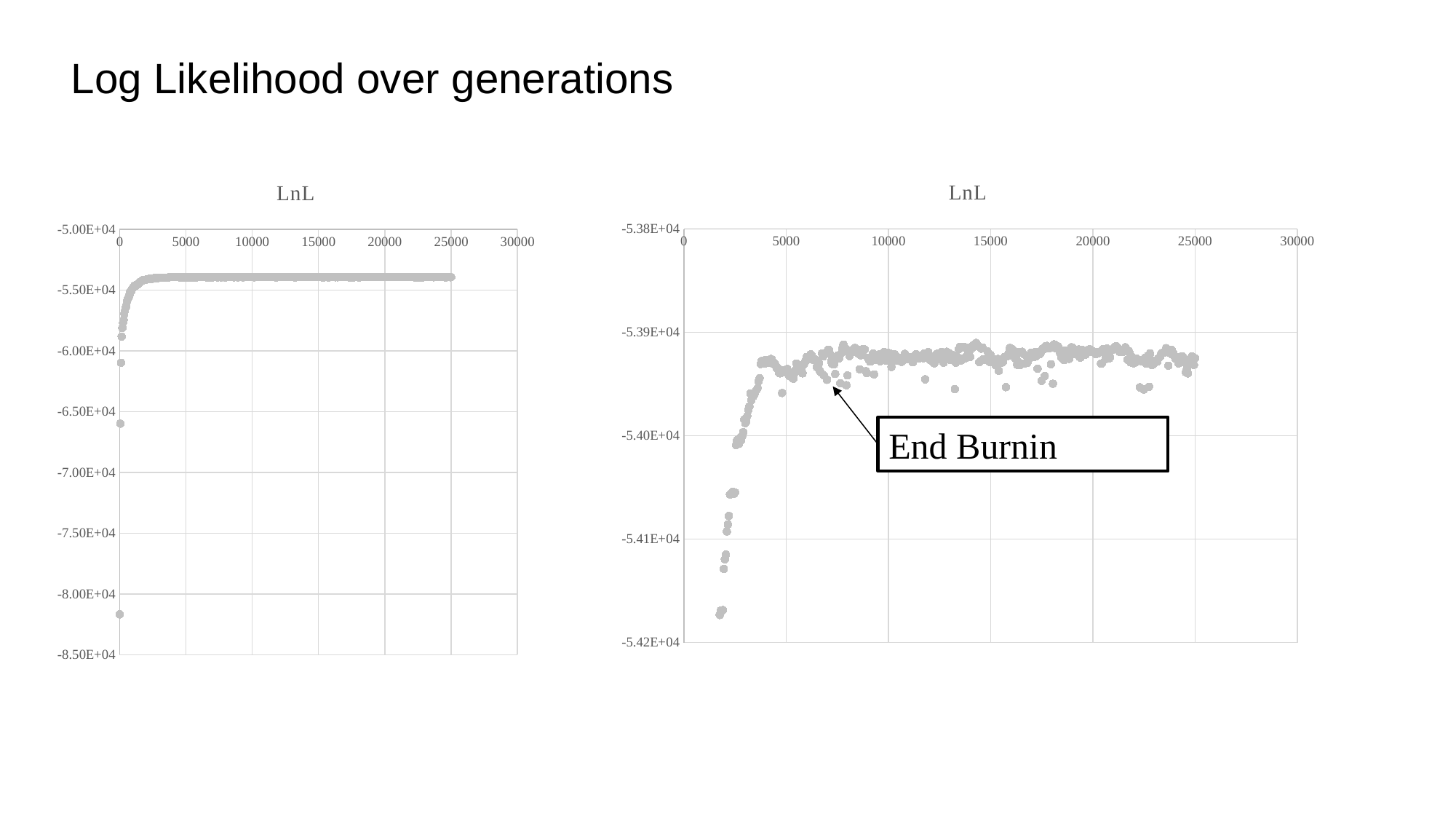
In the left chart, is the LnL value at generation 25000 greater or less than -5.50E+04? greater In the left chart, do the LnL values rise or fall as the generations increase from 0? rise In the left chart, is the LnL value at generation 0 greater or less than -8.00E+04? less What is the title shown above each of the two charts? LnL What text is in the annotation box on the right chart? End Burnin In the right chart, which is larger: the LnL value near generation 2000 or the LnL value near generation 15000? generation 15000 In the right chart, is the LnL value at generation 20000 greater or less than -5.40E+04? greater In the right chart, do the LnL values rise or fall between generation 0 and generation 5000? rise In the left chart, which is larger: the LnL value at generation 0 or the LnL value at generation 25000? generation 25000 What kind of chart is the right chart titled LnL? scatter chart What kind of chart is the left chart titled LnL? scatter chart